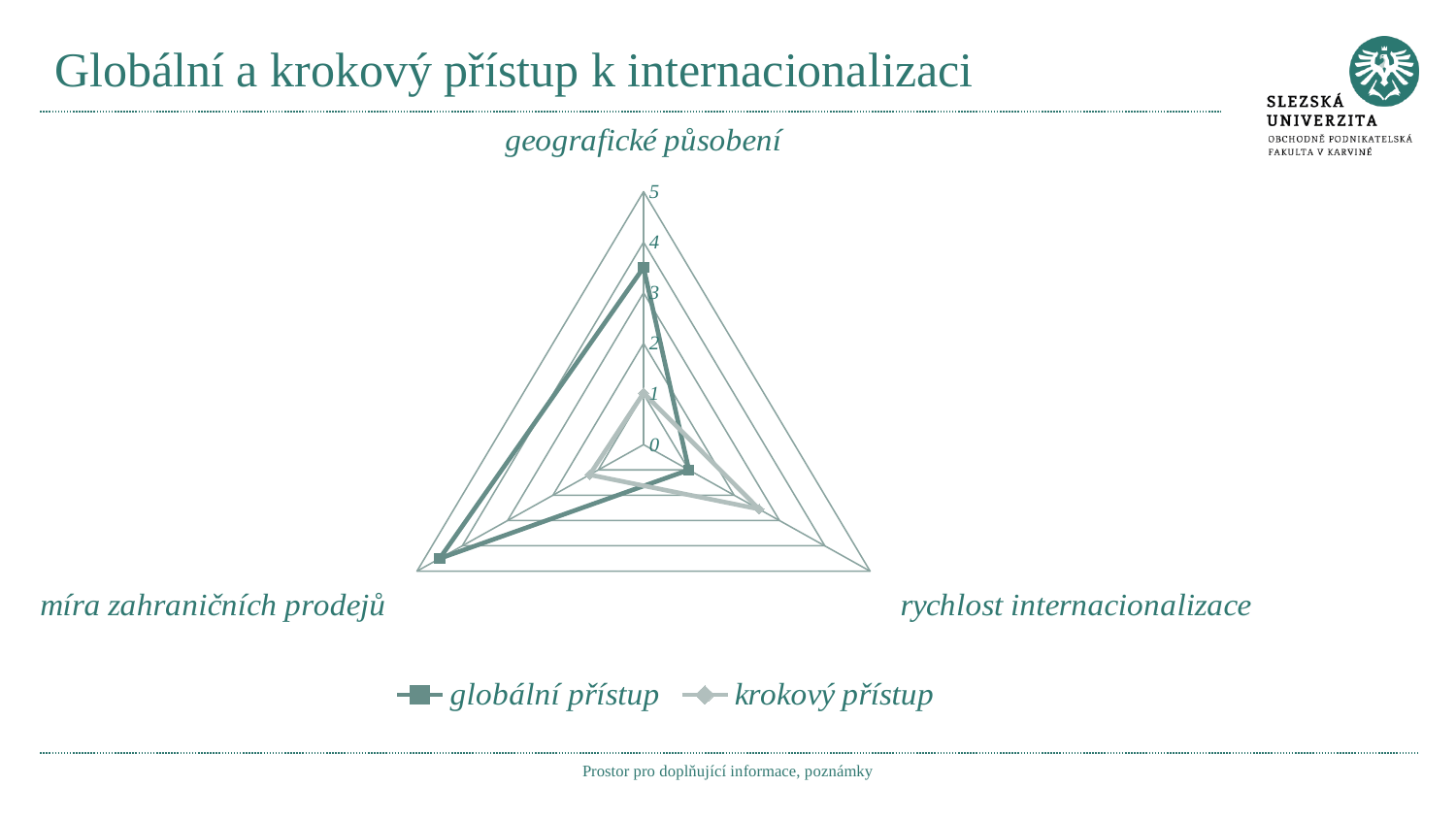
What kind of chart is shown on the slide? radar chart Which series has the higher value for geografické působení? globální přístup How many series does the legend list? 2 Is the value of krokový přístup for rychlost internacionalizace greater or less than 2? greater Is the value of globální přístup for míra zahraničních prodejů greater or less than 4? greater What are the two series named in the legend? globální přístup, krokový přístup Which series has the higher value for rychlost internacionalizace? krokový přístup Is the value of globální přístup for rychlost internacionalizace greater or less than 2? less How many axes (categories) does the radar chart have? 3 On which axis does globální přístup reach its highest value? míra zahraničních prodejů